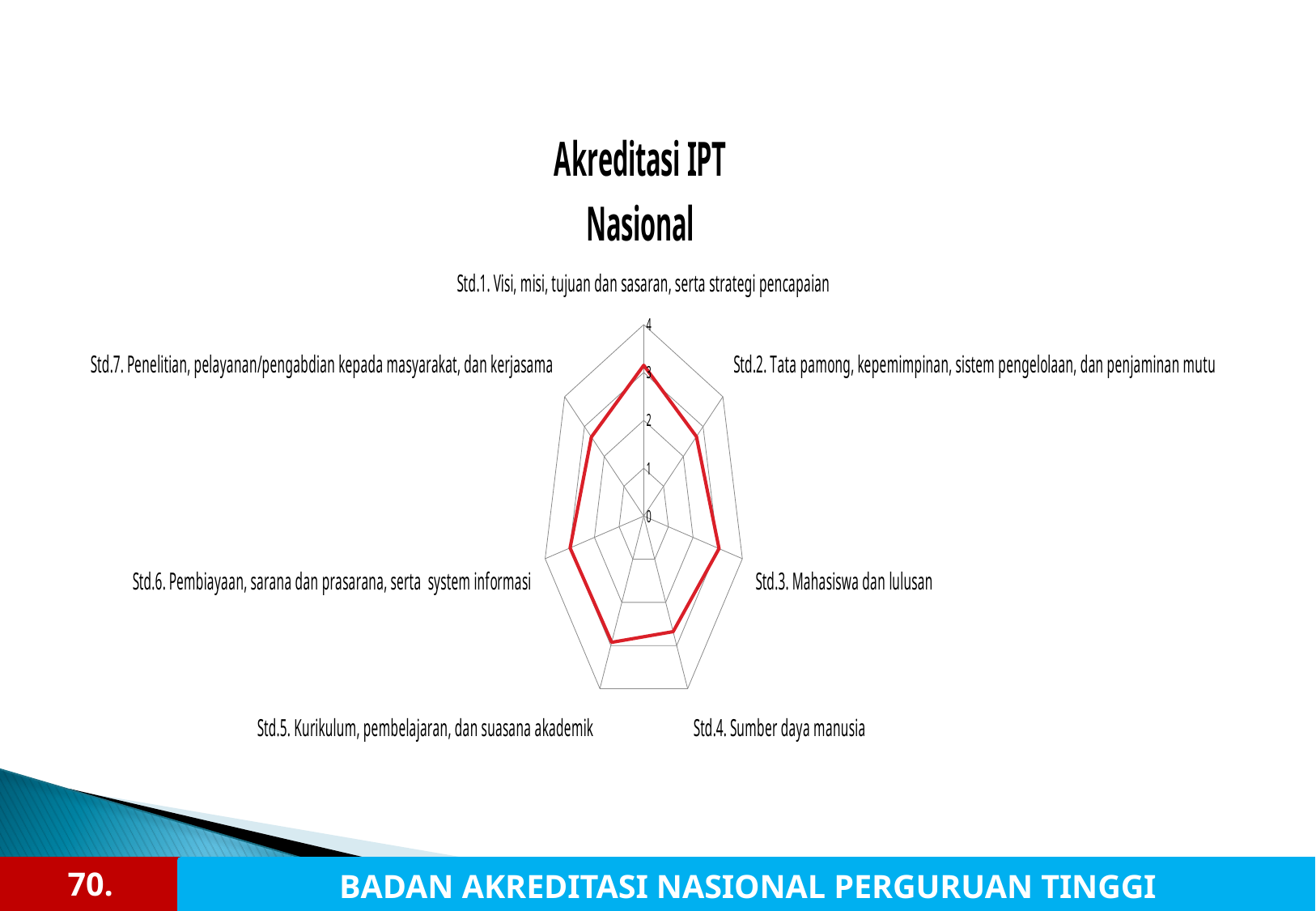
Is the value for Std.4 (Sumber daya manusia) greater or less than 2? greater Is the value for Std.7 (Penelitian, pelayanan/pengabdian kepada masyarakat, dan kerjasama) greater or less than 4? less How many standards (categories) are plotted on the radar chart? 7 Is the value for Std.2 (Tata pamong, kepemimpinan, sistem pengelolaan, dan penjaminan mutu) greater or less than 1? greater What kind of chart is shown on the slide? Radar chart What is the maximum value shown on the chart's scale? 4 What is the title of the chart? Akreditasi IPT Nasional